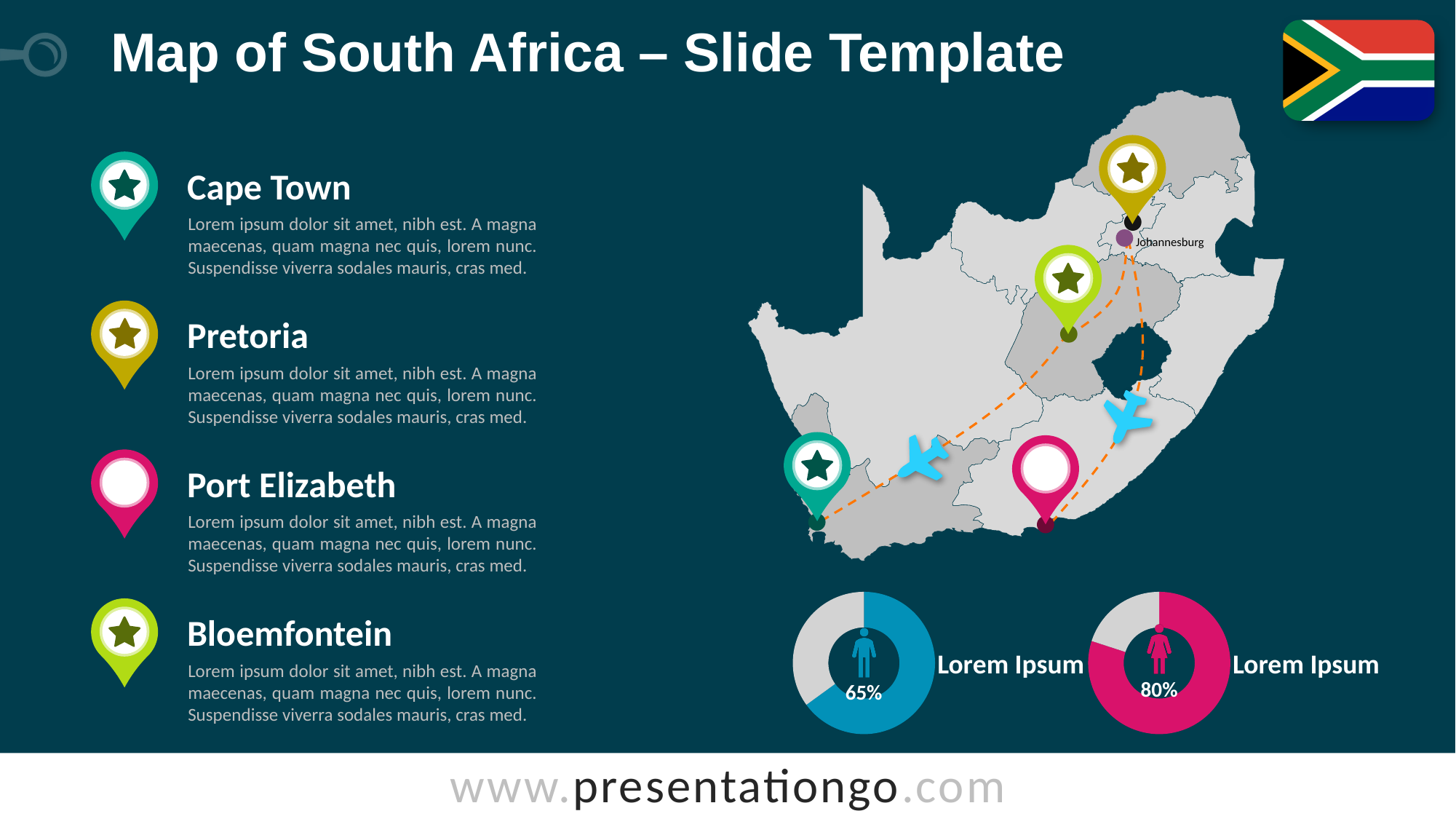
Which of the two donut charts shows the larger percentage, the left one or the right one? the right one (80%) What colour is the filled segment of the left donut chart? blue What percentage is shown in the right donut chart at the bottom of the slide? 80% Is the value in the left donut chart greater or less than 50%? greater What kind of chart is used to display the 65% and 80% values? donut (pie) chart What is the difference between the percentages shown in the right and left donut charts? 15 percentage points What label appears next to each of the two donut charts? Lorem Ipsum What percentage is shown in the left donut chart at the bottom of the slide? 65% How many donut charts are on the slide? 2 Is the value in the right donut chart greater or less than 75%? greater What share of the left donut chart is not filled by the 65% segment? 35%